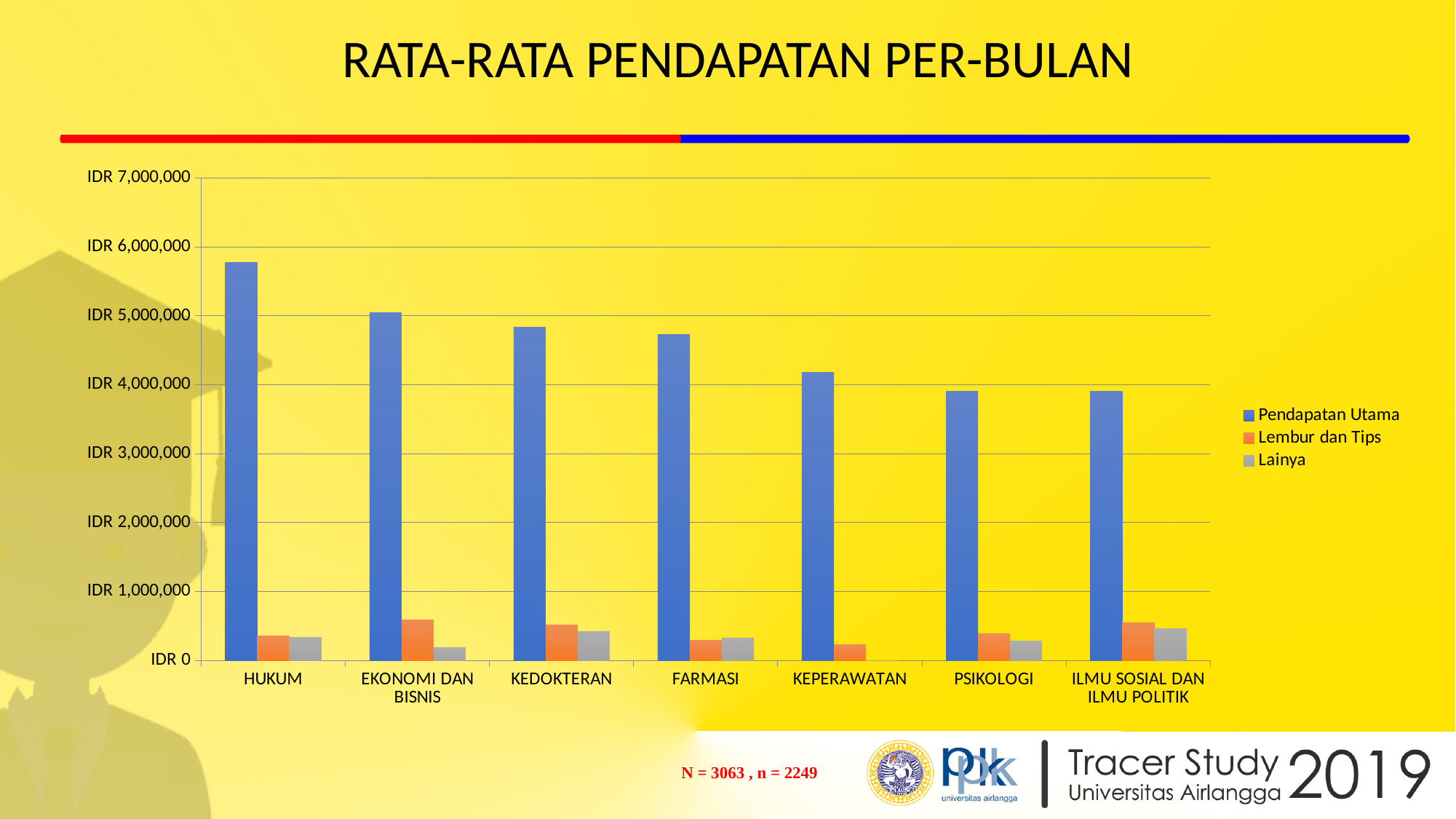
Is the Pendapatan Utama value for FARMASI greater or less than IDR 5,000,000? less Do the Pendapatan Utama values rise or fall from left to right along the x axis? fall Is the Pendapatan Utama value for PSIKOLOGI greater or less than IDR 4,000,000? less How many categories (faculties) are shown on the x axis? 7 Which category has the highest Pendapatan Utama? HUKUM Which is larger, the Pendapatan Utama for HUKUM or for FARMASI? HUKUM Which category has the highest Lembur dan Tips value? EKONOMI DAN BISNIS What is the title of the chart? RATA-RATA PENDAPATAN PER-BULAN How many series does the legend list? 3 What kind of chart is shown on the slide? bar chart Which category has the lowest Lembur dan Tips value? KEPERAWATAN Is the Pendapatan Utama value for HUKUM greater or less than IDR 5,000,000? greater